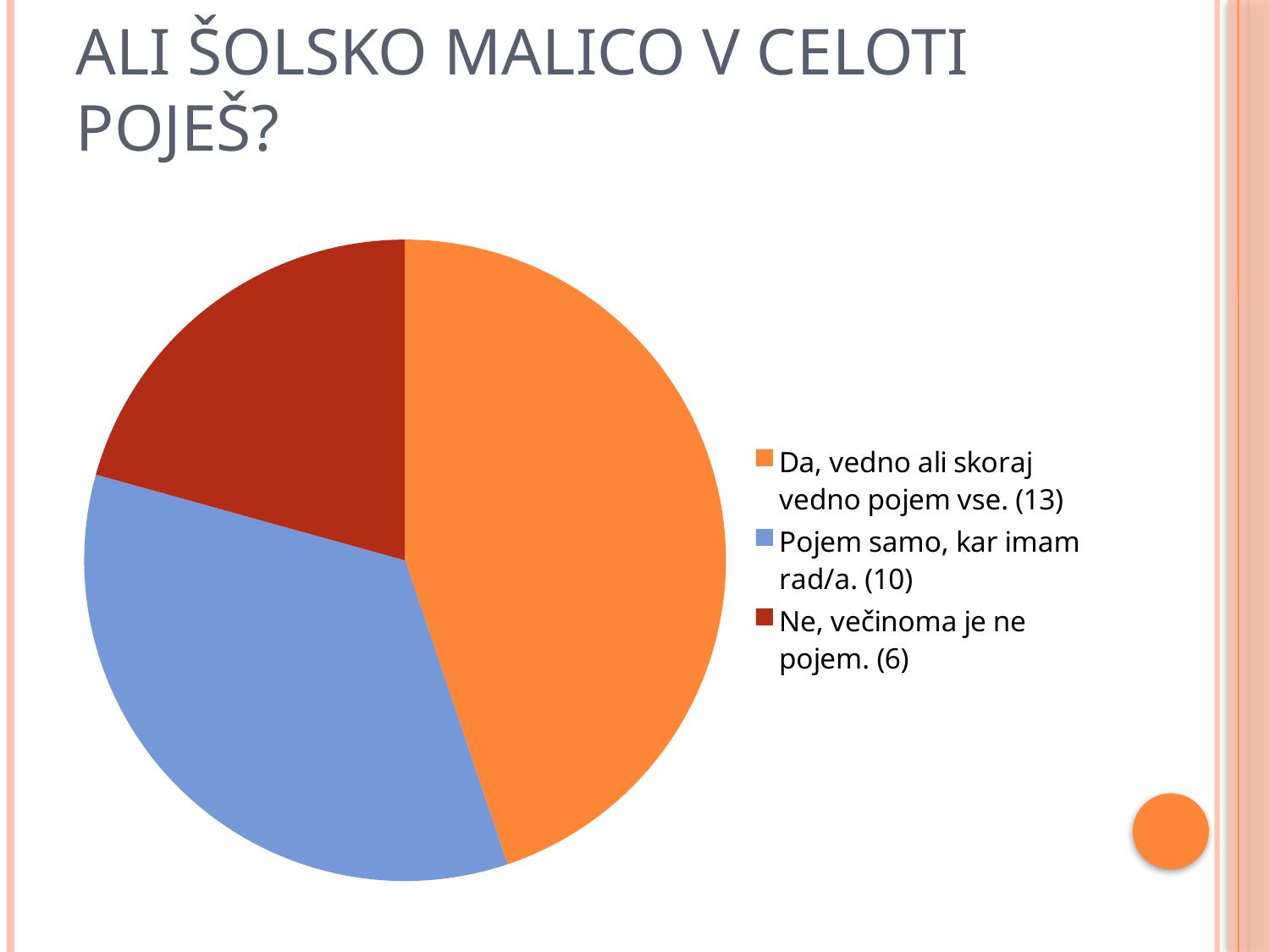
What is the value for "Ne, večinoma je ne pojem."? 6 What is the difference between the values for "Da, vedno ali skoraj vedno pojem vse." and "Ne, večinoma je ne pojem."? 7 What is the value for "Da, vedno ali skoraj vedno pojem vse."? 13 What is the value for "Pojem samo, kar imam rad/a."? 10 Which category has the smallest slice of the pie? Ne, večinoma je ne pojem. What colour is the slice for "Ne, večinoma je ne pojem."? dark red Which is larger: the value for "Pojem samo, kar imam rad/a." or the value for "Ne, večinoma je ne pojem."? Pojem samo, kar imam rad/a. How many entries does the legend list? 3 What is the total of all three values shown in the legend? 29 What kind of chart is shown on the slide? pie chart How many slices does the pie chart have? 3 Which category has the largest slice of the pie? Da, vedno ali skoraj vedno pojem vse.